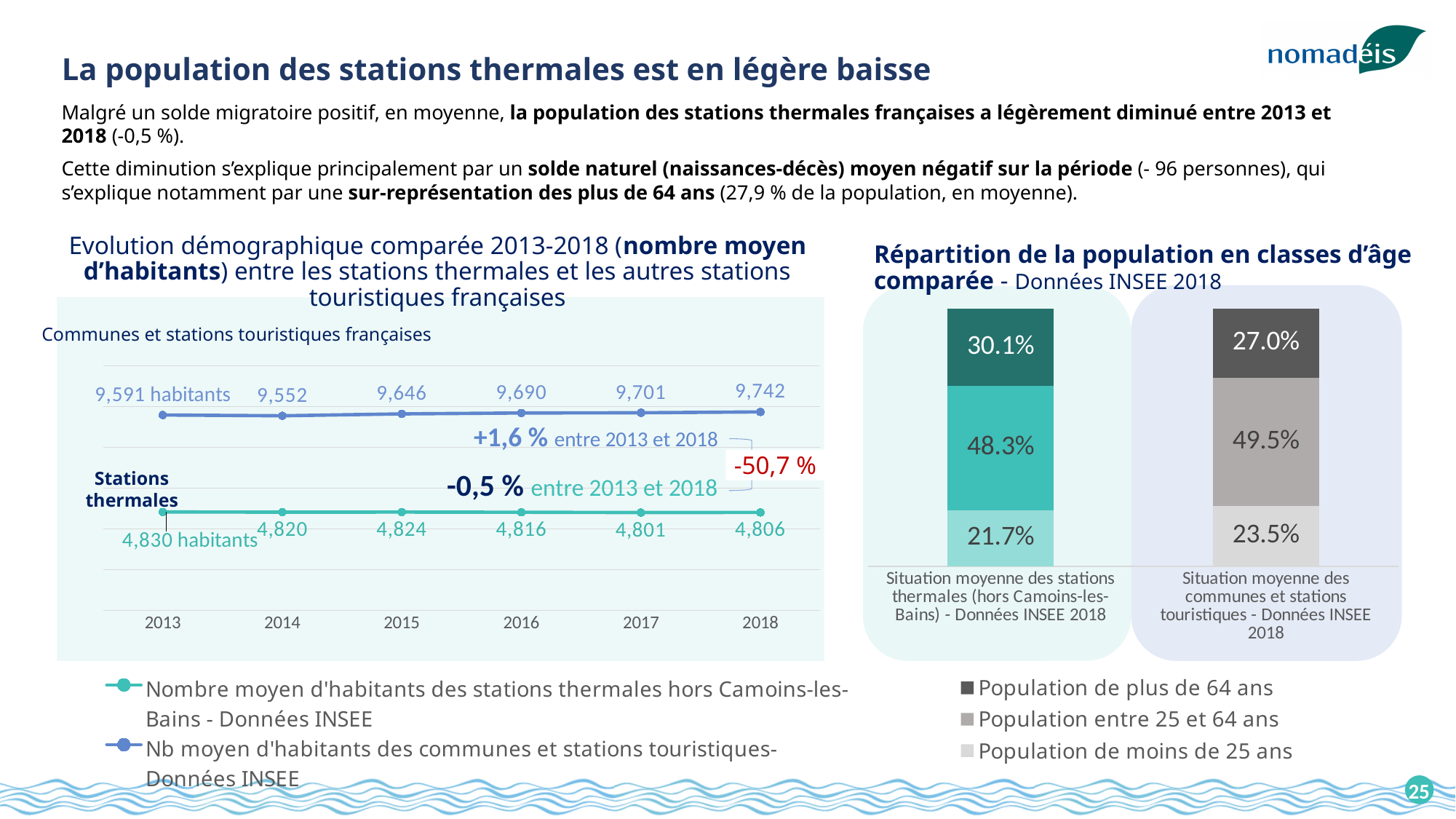
In the right chart (Répartition de la population en classes d'âge comparée), what is the share of Population de plus de 64 ans for the stations thermales? 30.1% In the left chart (Evolution démographique comparée 2013-2018), does the communes et stations touristiques series rise or fall between 2014 and 2018? rise In the left chart (Evolution démographique comparée 2013-2018), what is the difference between the stations thermales values in 2013 and 2018? 24 In the left chart (Evolution démographique comparée 2013-2018), in which year is the stations thermales series highest? 2013 How many series does the legend of the right chart (Répartition de la population en classes d'âge comparée) list? 3 What kind of chart is the left chart (Evolution démographique comparée 2013-2018)? line chart In the left chart (Evolution démographique comparée 2013-2018), how many years are shown on the x axis? 6 In the left chart (Evolution démographique comparée 2013-2018), in which year is the communes et stations touristiques series lowest? 2014 In the right chart (Répartition de la population en classes d'âge comparée), which bar has the larger share of Population entre 25 et 64 ans? Situation moyenne des communes et stations touristiques In the left chart (Evolution démographique comparée 2013-2018), what is the value for the communes et stations touristiques series in 2018? 9,742 In the left chart (Evolution démographique comparée 2013-2018), what is the value for the stations thermales series in 2017? 4,801 In the right chart (Répartition de la population en classes d'âge comparée), what is the share of Population de moins de 25 ans for the communes et stations touristiques? 23.5%